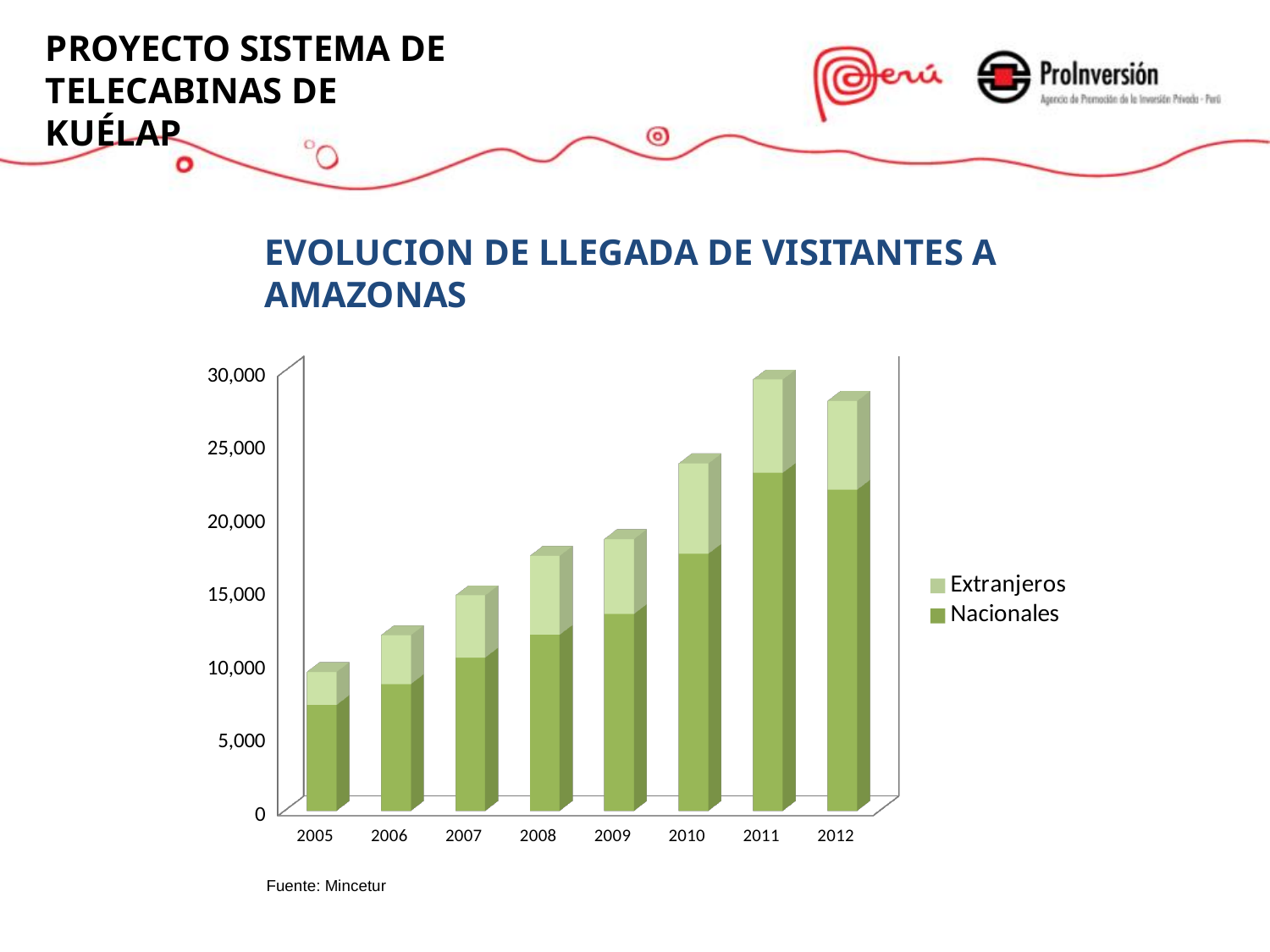
From 2005 to 2011, do the total bars rise or fall? rise What kind of chart is shown on the slide? bar chart Which year has the larger total bar, 2011 or 2012? 2011 Is the total bar for 2011 greater or less than 25,000? greater How many series does the chart's legend list? 2 Which year has the lowest total bar? 2005 Is the Nacionales value for 2012 greater or less than 20,000? greater Which year has the highest total bar? 2011 Which series are listed in the chart's legend? Extranjeros and Nacionales What is the title of the chart? EVOLUCION DE LLEGADA DE VISITANTES A AMAZONAS How many years are shown on the x axis of the chart? 8